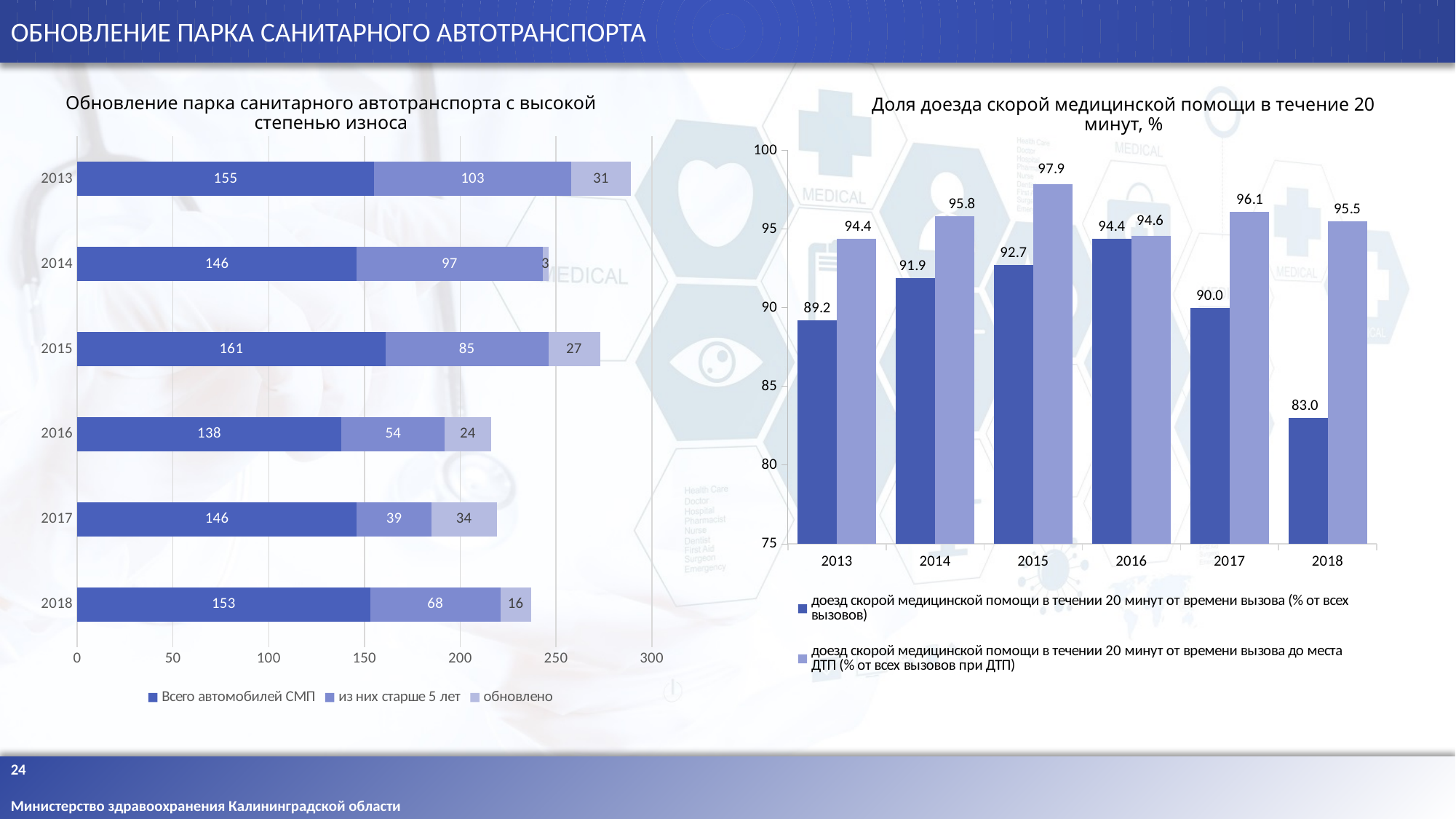
In the right chart, how many years are shown on the x axis? 6 In the left chart, what is the difference between 'Всего автомобилей СМП' in 2015 and in 2016? 23 In the left chart, which year has the lowest value for 'из них старше 5 лет'? 2017 In the right chart, which year has the highest value for the series about arrival at the scene of a road accident (ДТП)? 2015 In the left chart, how many series does the legend list? 3 In the left chart (Обновление парка санитарного автотранспорта с высокой степенью износа), what is the value of 'Всего автомобилей СМП' for 2015? 161 In the right chart, is the 2013 value for the series '% от всех вызовов' greater or less than 90? less In the right chart, what is the difference between the two series' values in 2017? 6.1 What type of chart is the left chart? Stacked bar chart In the right chart (Доля доезда скорой медицинской помощи в течение 20 минут, %), what is the value for 2018 for the series 'доезд скорой медицинской помощи в течении 20 минут от времени вызова (% от всех вызовов)'? 83.0 In the left chart, what is the total of the stacked bar for 2016? 216 In the left chart, what is the value of 'обновлено' for 2017? 34